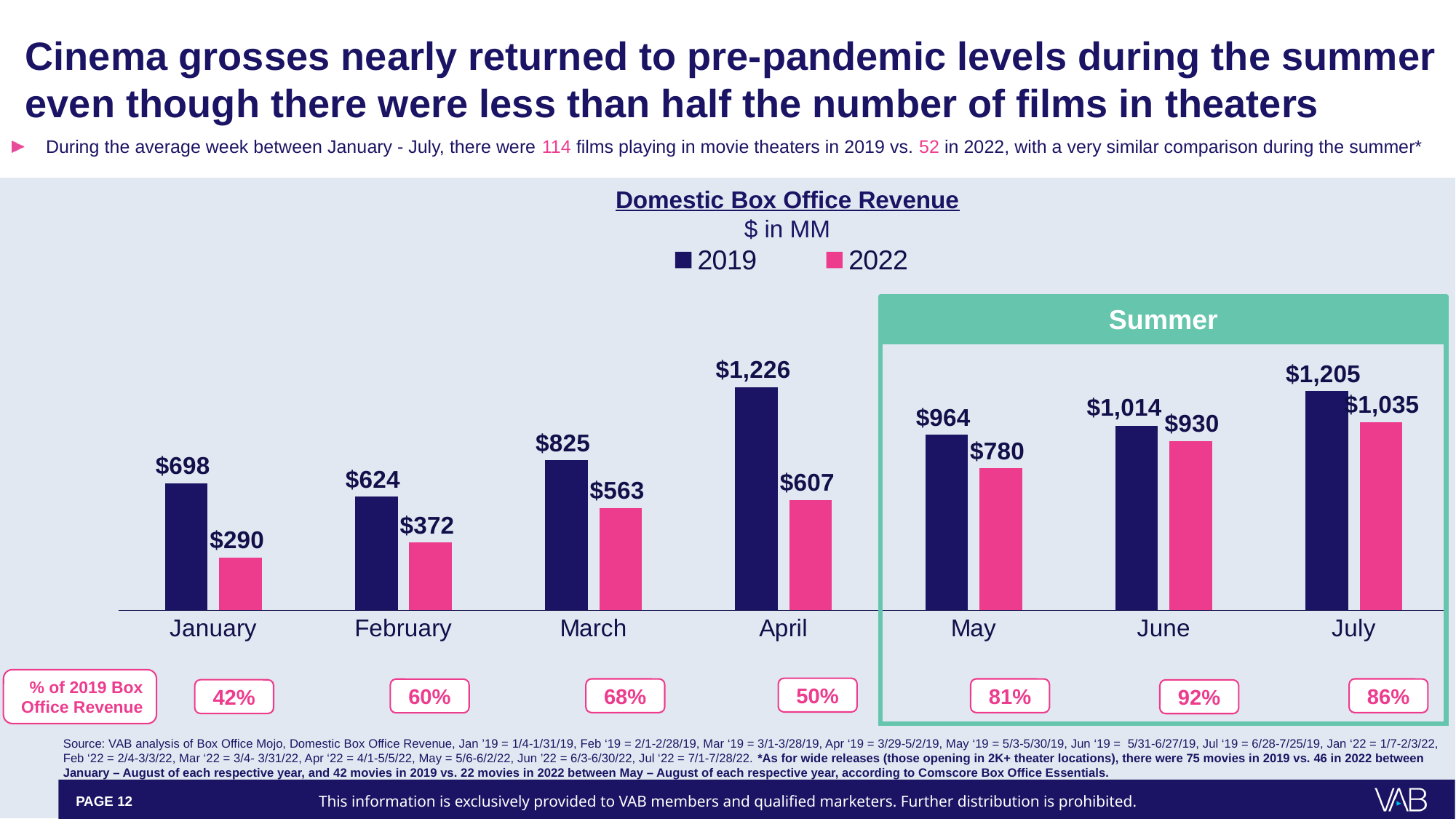
How many months are shown on the x axis? 7 What is the 2019 domestic box office revenue for April? $1,226 What kind of chart is shown? Bar chart How many series does the legend list? 2 What is the 2022 value for July? $1,035 Which month has the lowest 2022 value? January What is the title of the chart? Domestic Box Office Revenue What is the 2022 domestic box office revenue for January? $290 Which is larger, the 2022 value for June or the 2022 value for May? June What is the difference between the 2019 and 2022 values for March? $262 Which month has the highest 2019 value? April What percentage of 2019 box office revenue is shown for June? 92%